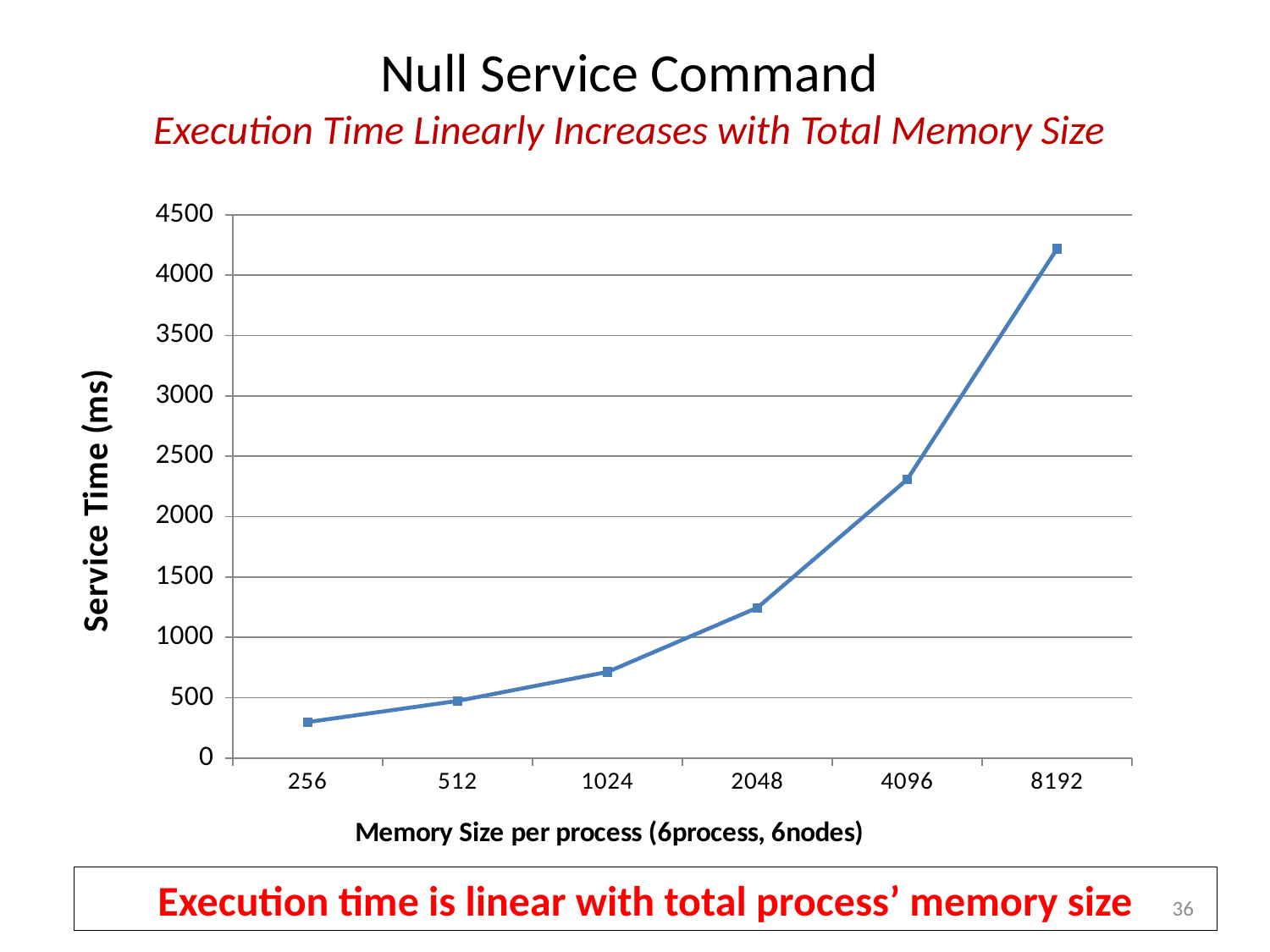
What kind of chart is shown on the slide? line chart Is the service time for memory size 2048 greater or less than 1000? greater Is the service time for memory size 256 greater or less than 500? less Which has a larger service time, memory size 4096 or memory size 2048? 4096 Which memory size has the highest service time? 8192 What is the title of the y axis? Service Time (ms) Is the service time for memory size 4096 greater or less than 2000? greater Do the service time values rise or fall as memory size increases along the x axis? rise Which memory size has the lowest service time? 256 How many data points are plotted on the line? 6